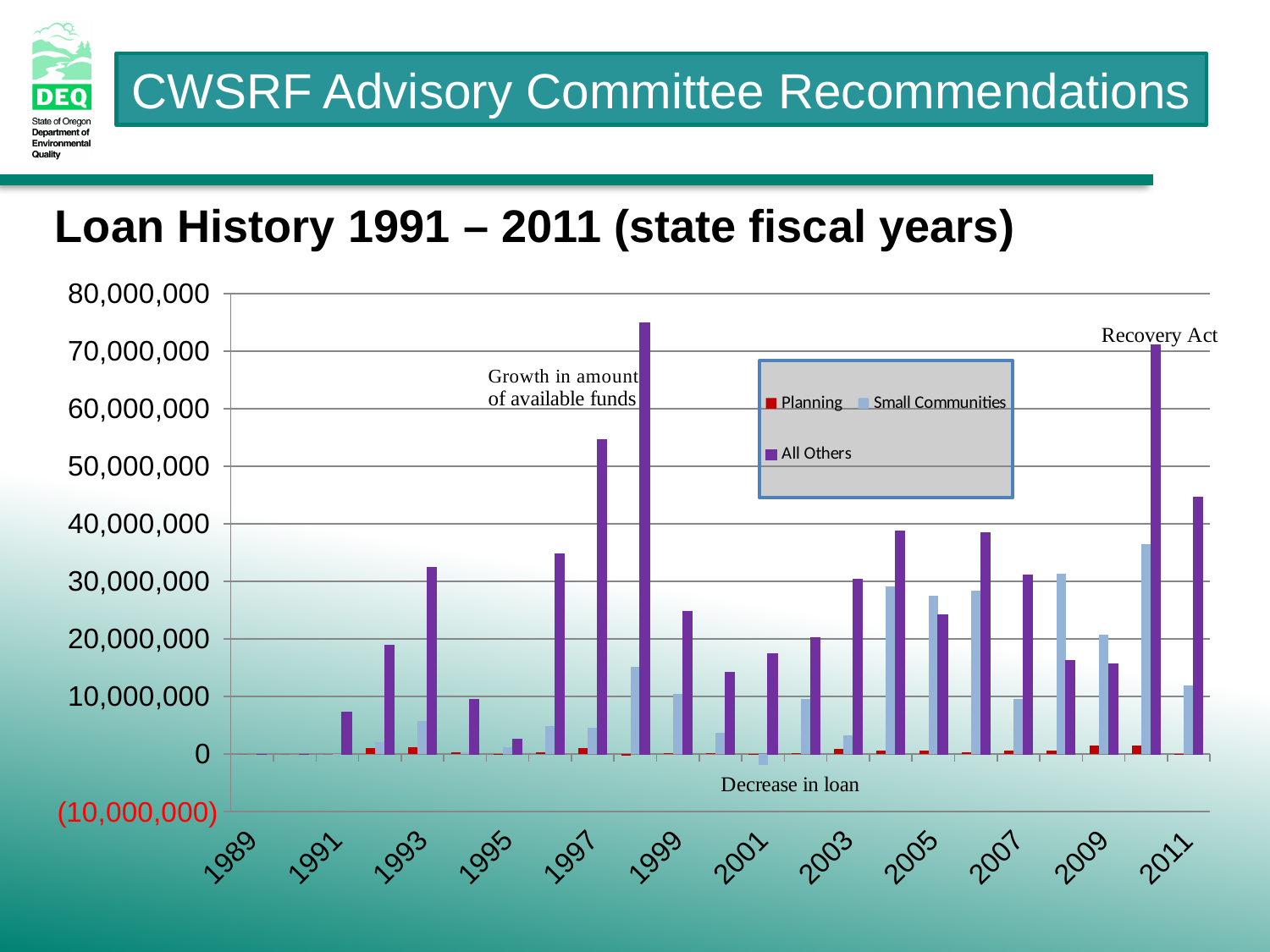
Is the All Others value for 1991 greater or less than 10,000,000? less Is the All Others value for 2011 greater or less than 40,000,000? greater Which annotation on the chart labels the tallest bar near 2010? Recovery Act Is the All Others value for 1997 greater or less than 50,000,000? greater What are the three series named in the legend? Planning, Small Communities, All Others In 2011, which series has the larger value, Small Communities or All Others? All Others How many series does the legend list? 3 What kind of chart is shown on the slide? Bar chart How many year labels are shown along the x axis? 12 Which is larger, the All Others value for 1997 or for 1999? 1997